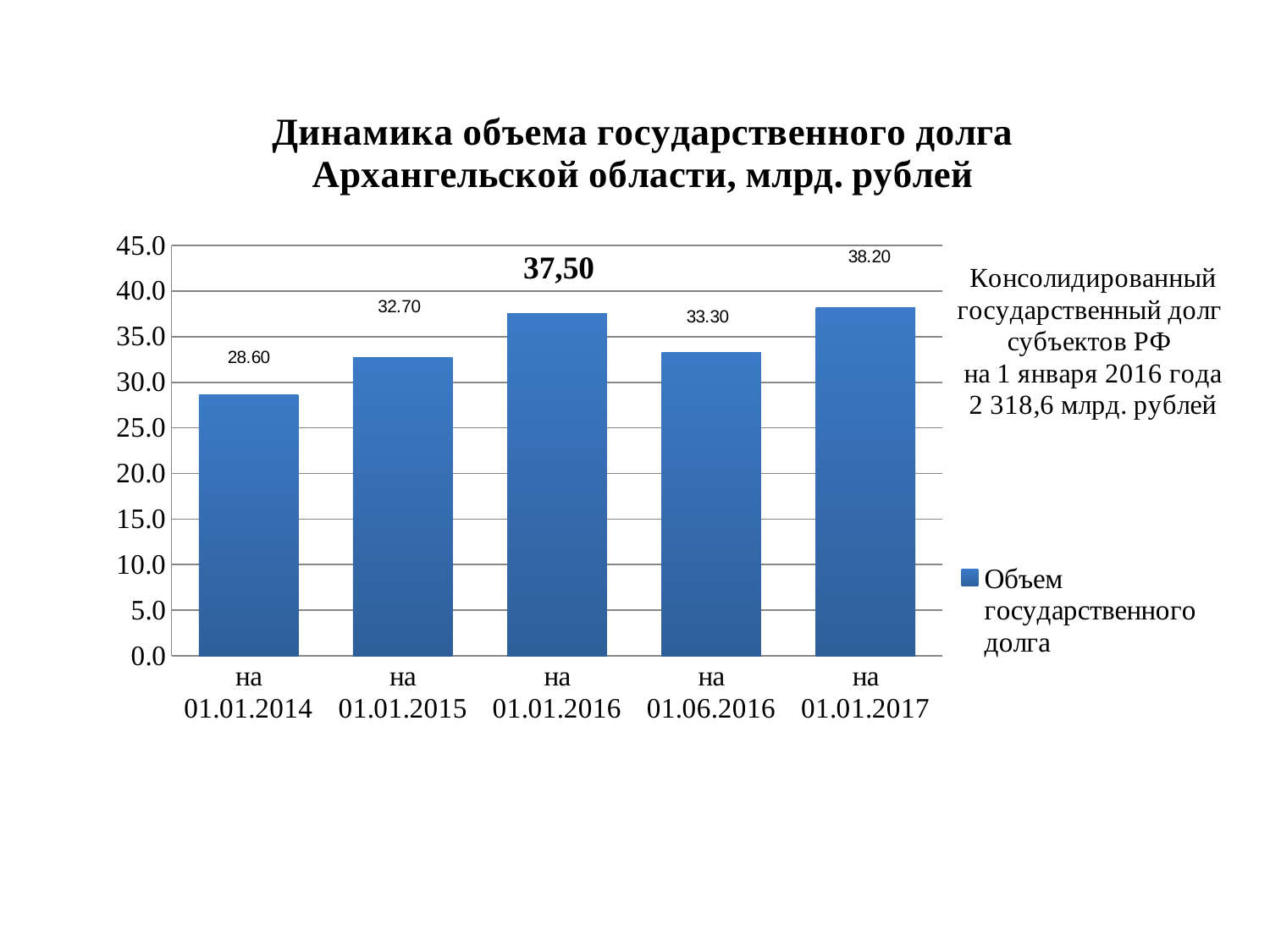
What is the value for на 01.01.2017? 38.20 Which category has the lowest value? на 01.01.2014 How many categories are shown on the x axis? 5 What is the value for на 01.01.2015? 32.70 Which is larger, the value for на 01.01.2015 or на 01.06.2016? на 01.06.2016 What is the value for на 01.01.2016? 37,50 Which category has the highest value? на 01.01.2017 What kind of chart is shown on the slide? bar chart What is the value for на 01.06.2016? 33.30 What is the difference between the values for на 01.01.2017 and на 01.01.2014? 9.60 What is the value for на 01.01.2014? 28.60 What series does the legend list? Объем государственного долга